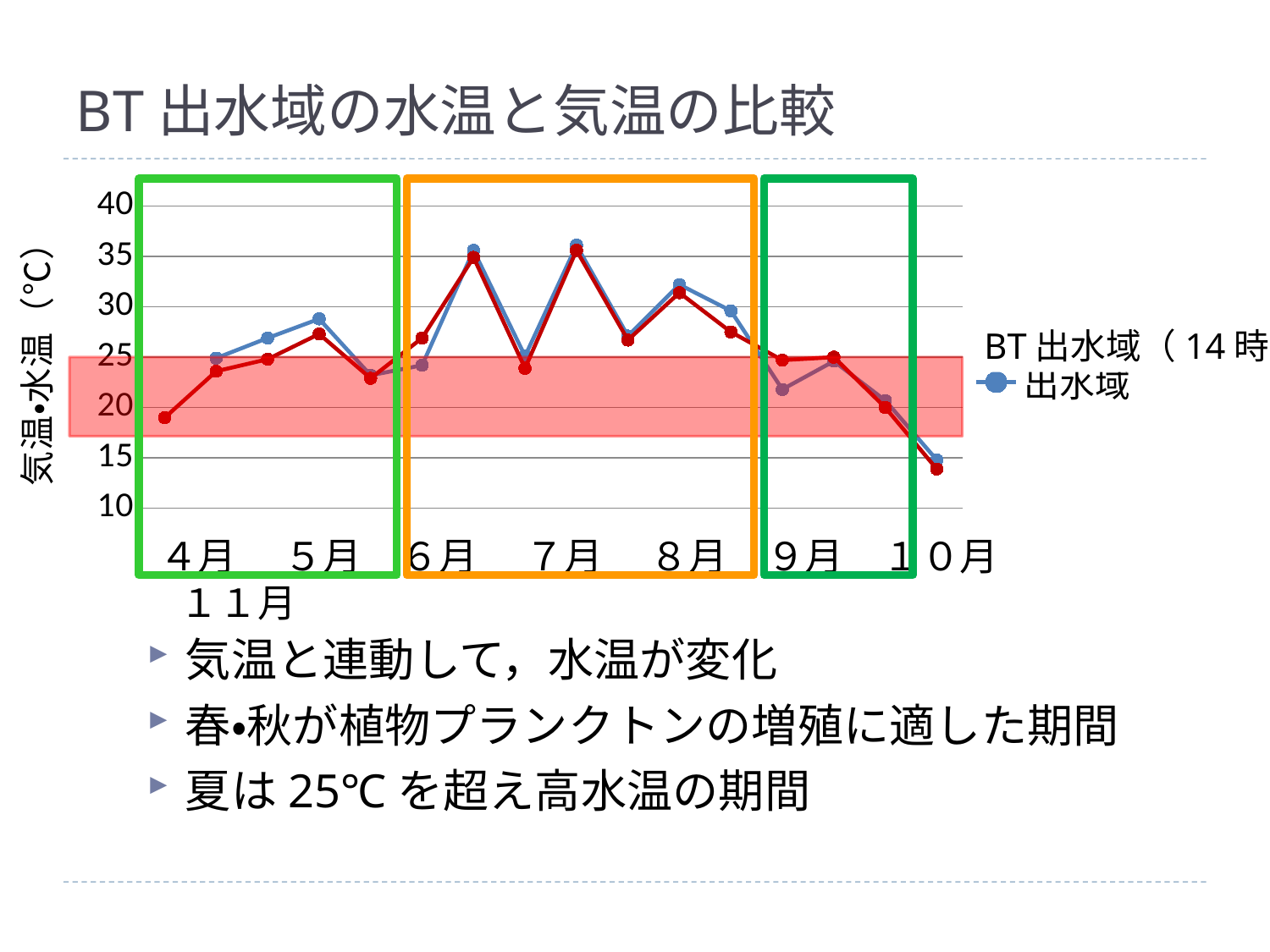
What kind of chart is shown on the slide? line chart What is the title of the chart on the slide? BT出水域の水温と気温の比較 How many series does the legend list? 2 How many months are labelled along the x axis? 8 Do the values of the blue series rise or fall from 4月 to 5月? rise What is the label of the vertical axis? 気温•水温（℃）